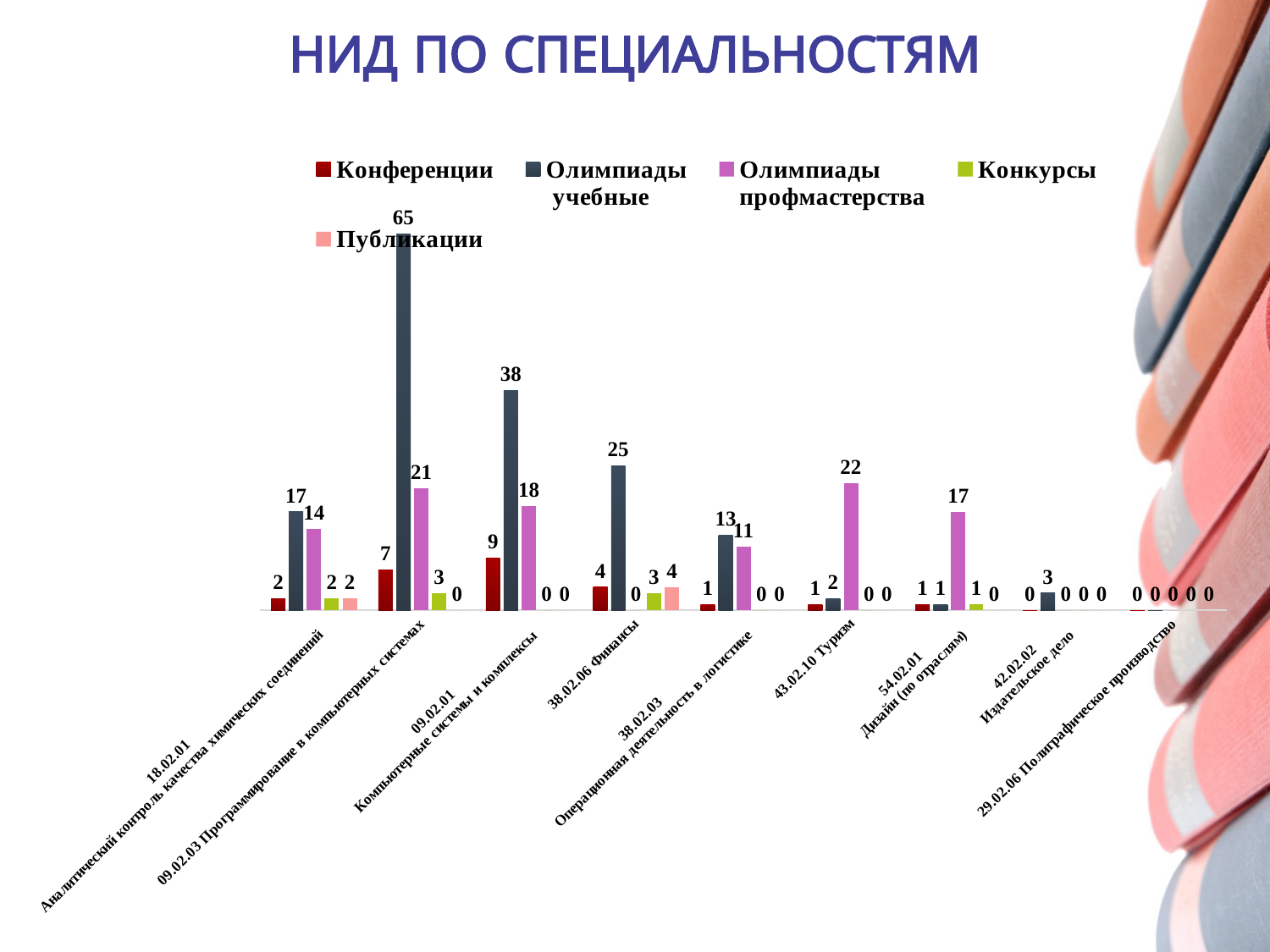
What is the difference between Олимпиады учебные for 09.02.03 Программирование в компьютерных системах and for 09.02.01 Компьютерные системы и комплексы? 27 What is the value of Публикации for 38.02.06 Финансы? 4 How many series does the legend list? 5 Which specialty has the highest value for Олимпиады учебные? 09.02.03 Программирование в компьютерных системах How many specialties (categories) are shown on the x axis? 9 What is the value of Олимпиады учебные for 09.02.03 Программирование в компьютерных системах? 65 Which specialty has the highest value for Конференции? 09.02.01 Компьютерные системы и комплексы Which is larger for 38.02.03 Операционная деятельность в логистике: Олимпиады учебные or Олимпиады профмастерства? Олимпиады учебные What type of chart is shown on the slide? bar chart What is the value of Олимпиады профмастерства for 43.02.10 Туризм? 22 What is the value of Конференции for 09.02.01 Компьютерные системы и комплексы? 9 What is the title of the chart on the slide? НИД ПО СПЕЦИАЛЬНОСТЯМ